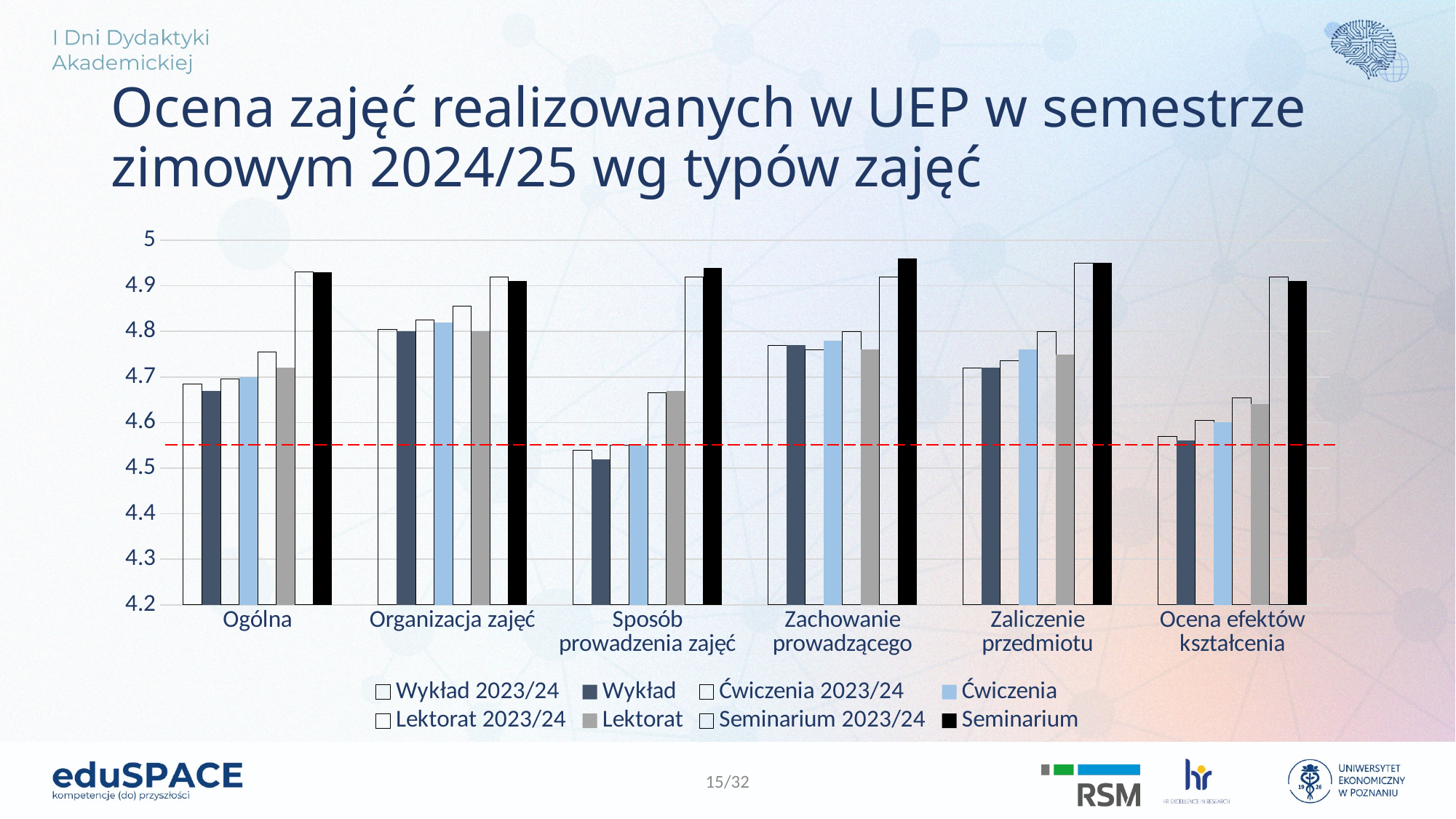
Is the value for Wykład in the Zaliczenie przedmiotu category greater or less than 4.8? less Is the value for Wykład in the Sposób prowadzenia zajęć category greater or less than 4.6? less How many series does the chart legend list? 8 What is the title of the chart on the slide? Ocena zajęć realizowanych w UEP w semestrze zimowym 2024/25 wg typów zajęć Is the value for Seminarium in the Zachowanie prowadzącego category greater or less than 4.9? greater What colour are the Seminarium bars in the chart? black In the Ogólna category, which is larger: the Seminarium value or the Wykład value? Seminarium Which is larger: the Lektorat value for Sposób prowadzenia zajęć or the Lektorat value for Zachowanie prowadzącego? Zachowanie prowadzącego What kind of chart is shown on the slide? bar chart How many categories are shown on the x axis of the chart? 6